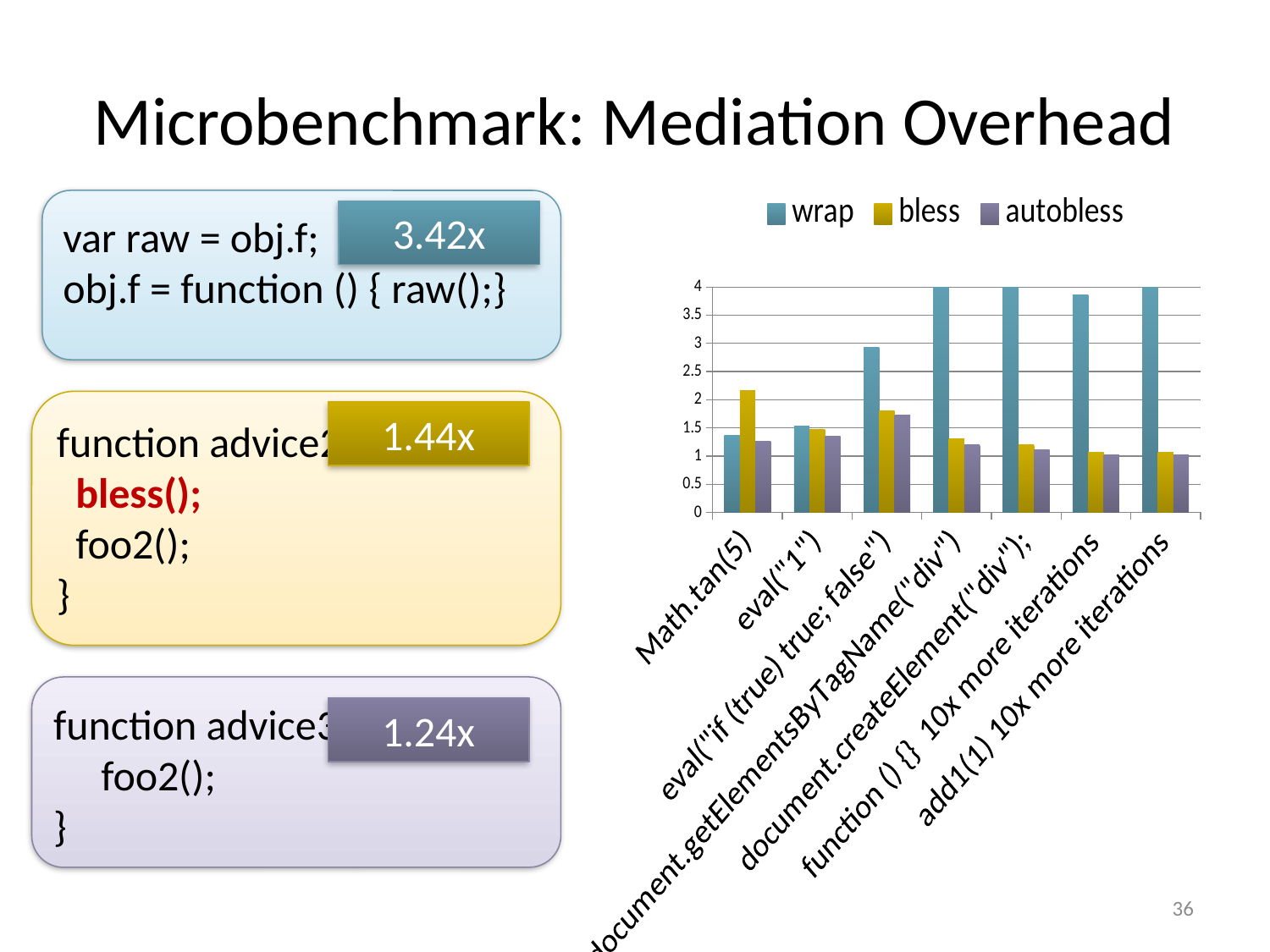
For eval("if (true) true; false"), which series has the larger value: wrap or autobless? wrap Is the wrap value for eval("if (true) true; false") greater or less than 2.5? greater What kind of chart is shown on the slide? bar chart Is the autobless value for document.createElement("div"); greater or less than 1.5? less For Math.tan(5), which series has the larger value: wrap or bless? bless What are the series names listed in the chart's legend? wrap, bless, autobless How many series does the chart's legend list? 3 How many categories are shown along the x axis of the chart? 7 Is the wrap value for Math.tan(5) greater or less than 1.5? less Which series has the lowest value for add1(1) 10x more iterations? autobless Which category has the highest bless value? Math.tan(5)